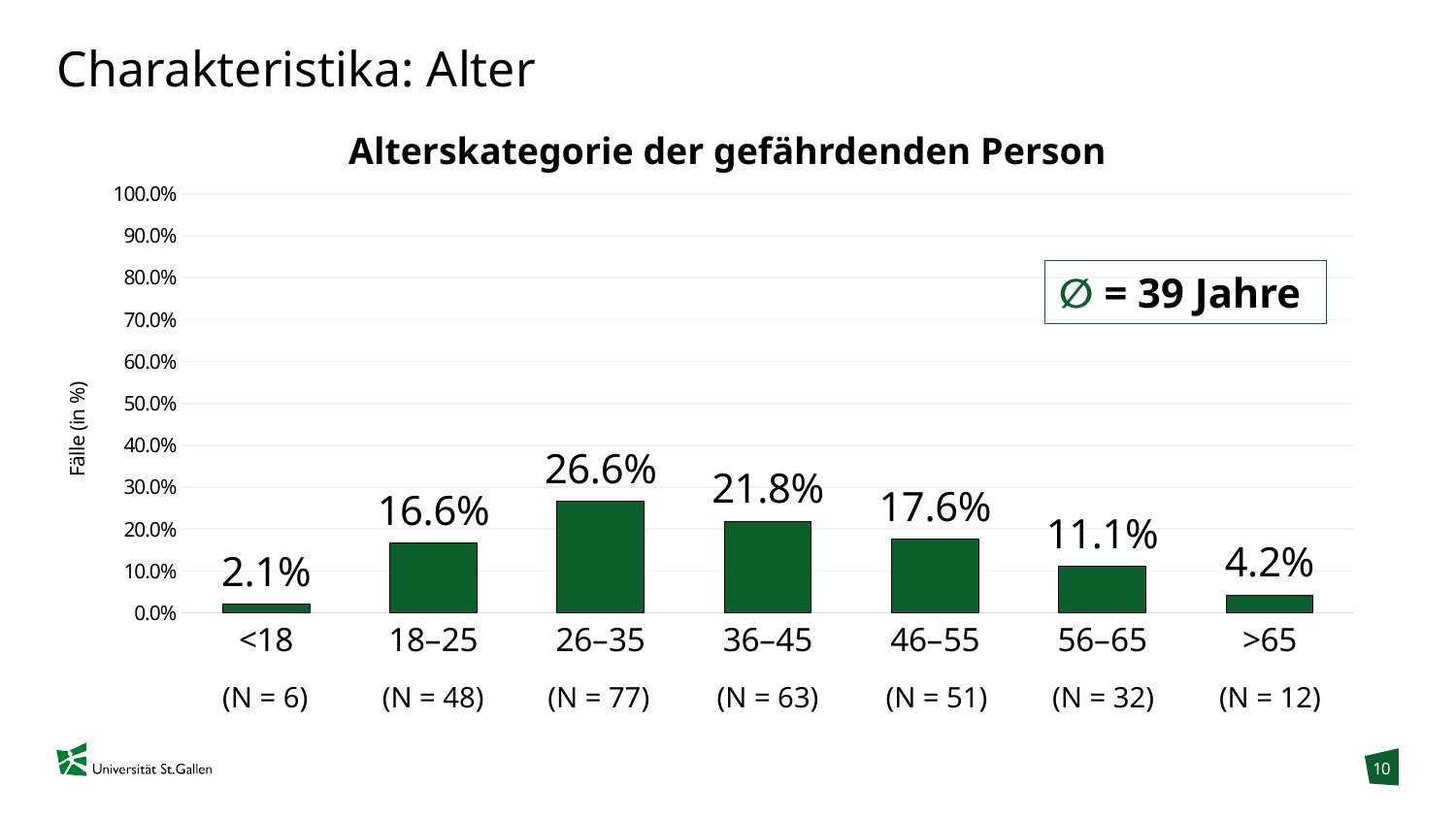
What kind of chart is shown on the slide? bar chart Which is larger, the value for 18–25 or the value for 46–55? 46–55 What is the title of the chart? Alterskategorie der gefährdenden Person What is the value for the 26–35 age category? 26.6% What is the N value shown for the 26–35 age category? N = 77 Which age category has the lowest value? <18 Which age category has the highest value? 26–35 What is the difference between the values for 26–35 and 36–45? 4.8% Is the value for 36–45 greater or less than 20.0%? greater What is the value for the 56–65 age category? 11.1% How many age categories are shown on the x axis? 7 What is the value for the <18 age category? 2.1%